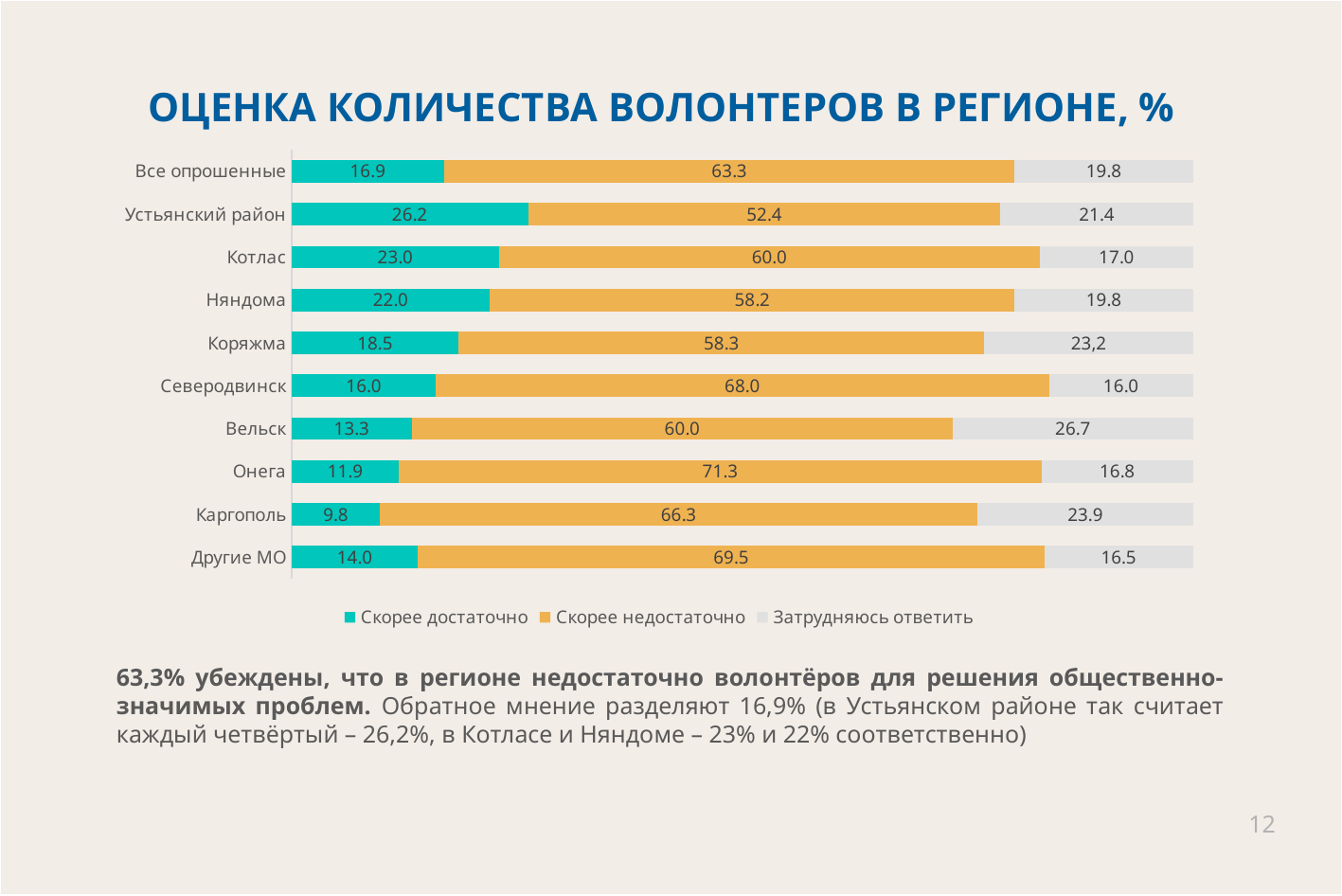
Which category has the lowest value for «Скорее достаточно»? Каргополь Which category has the highest value for «Скорее достаточно»? Устьянский район Which is larger: the «Скорее достаточно» value for Котлас or for Няндома? Котлас What is the value of «Скорее достаточно» for Устьянский район? 26.2 How many series does the legend list? 3 How many categories are shown on the chart? 10 What kind of chart is shown on the slide? Stacked bar chart What is the value of «Затрудняюсь ответить» for Вельск? 26.7 Which category has the highest value for «Скорее недостаточно»? Онега What is the value of «Скорее недостаточно» for Онега? 71.3 What is the title of the chart? ОЦЕНКА КОЛИЧЕСТВА ВОЛОНТЕРОВ В РЕГИОНЕ, % What is the difference between the «Скорее недостаточно» values for Северодвинск and Котлас? 8.0